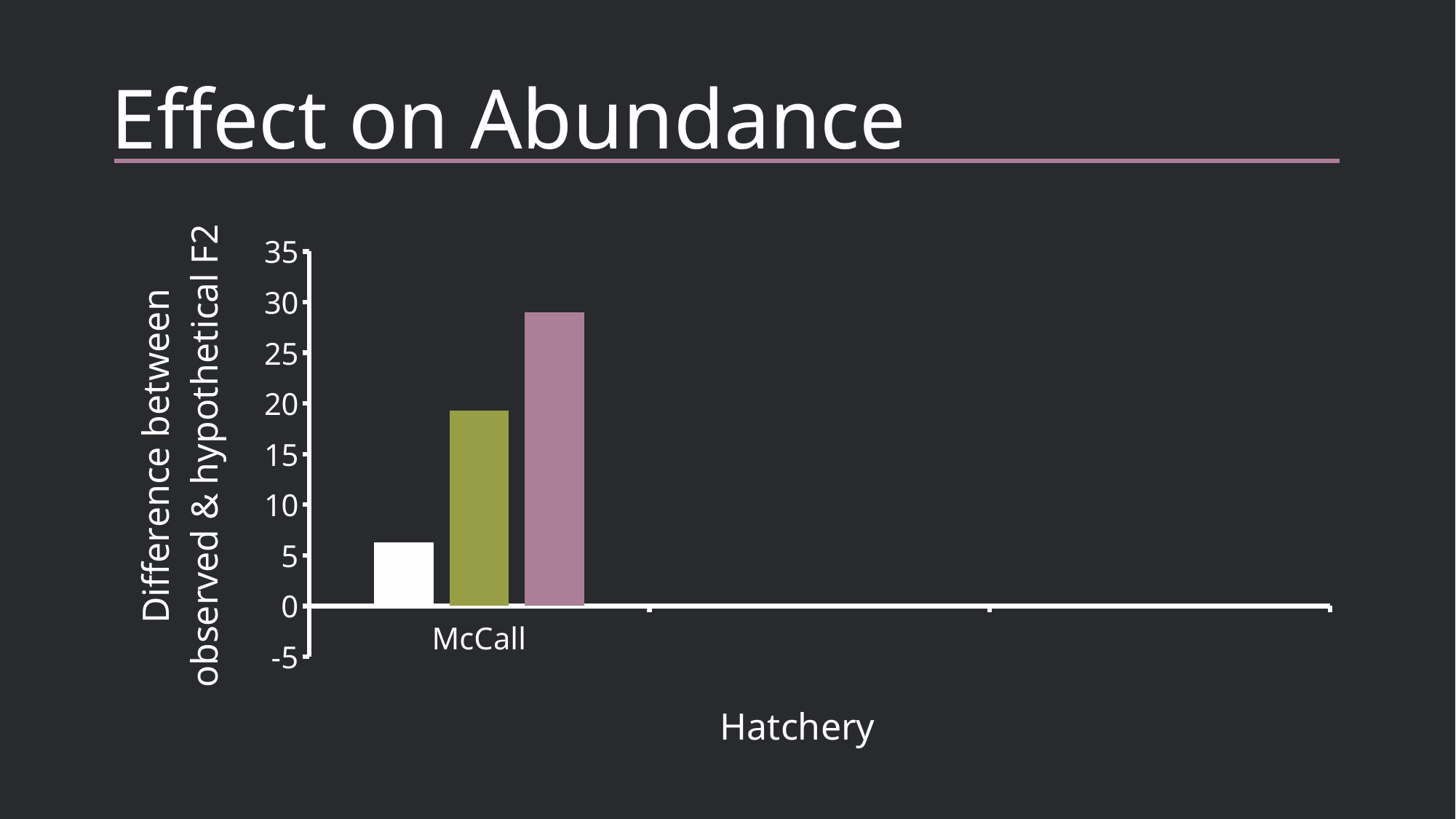
Is the value of the white bar for McCall greater or less than 10? less Which is larger for McCall, the olive bar or the white bar? olive bar Is the value of the pink bar for McCall greater or less than 25? greater What is the label on the x axis of the chart? Hatchery How many bars are plotted for the McCall category? 3 Is the value of the pink bar for McCall greater or less than 30? less What kind of chart is shown on the slide? bar chart What is the only category label shown on the x axis? McCall Which bar for McCall is the shortest: the white, the olive, or the pink one? white Which bar for McCall is the tallest: the white, the olive, or the pink one? pink What is the title of the slide? Effect on Abundance